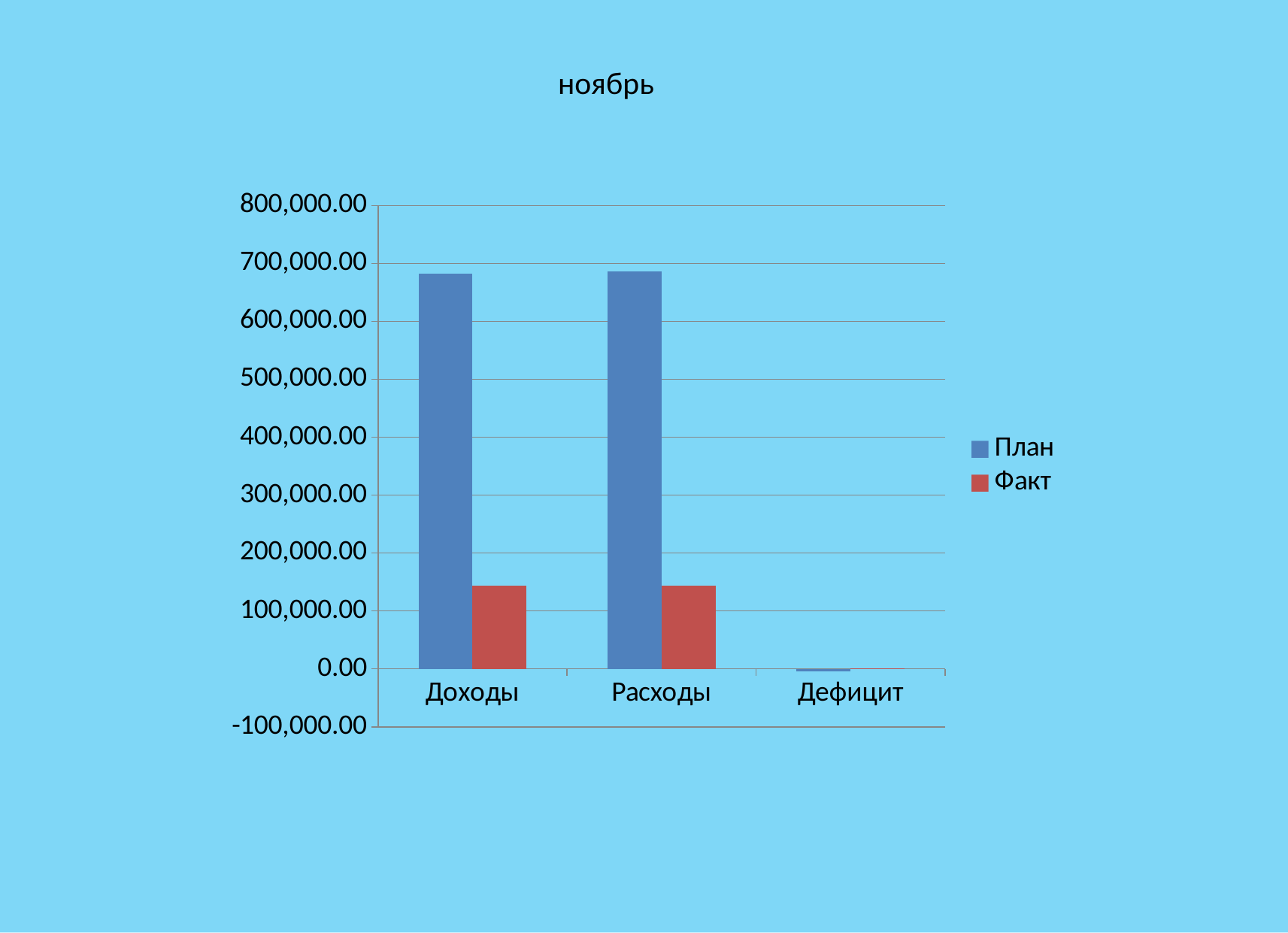
Is the План value for Расходы greater or less than 700,000.00? less Which series is shown in red in the legend? Факт How many categories are shown on the x axis? 3 For Доходы, which is larger: the План value or the Факт value? План Is the Факт value for Доходы greater or less than 100,000.00? greater How many series does the legend list? 2 What is the title of the chart? ноябрь What type of chart is shown on the slide? bar chart For Расходы, which is larger: the План value or the Факт value? План Is the План value for Доходы greater or less than 600,000.00? greater Which category has the lowest План value? Дефицит